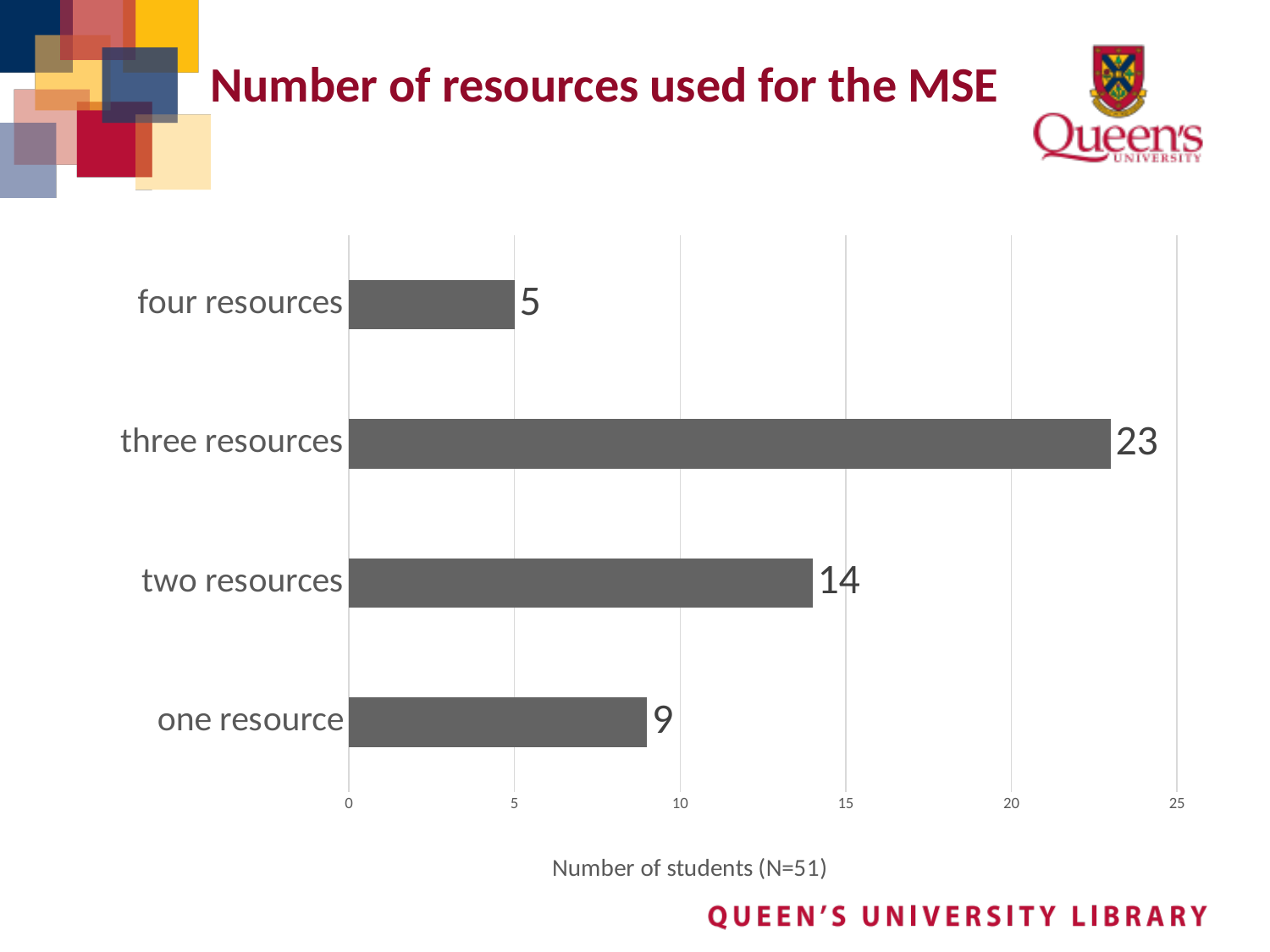
Which has more students: two resources or one resource? two resources How many students used one resource for the MSE? 9 Which category has the lowest number of students? four resources What is the title of the chart? Number of resources used for the MSE What is the difference in number of students between three resources and two resources? 9 How many students used four resources for the MSE? 5 How many categories are shown in the chart? 4 Which category has the highest number of students? three resources Is the value for two resources greater or less than 10? greater How many students used three resources for the MSE? 23 What is the label of the horizontal axis? Number of students (N=51) What kind of chart is shown on the slide? bar chart